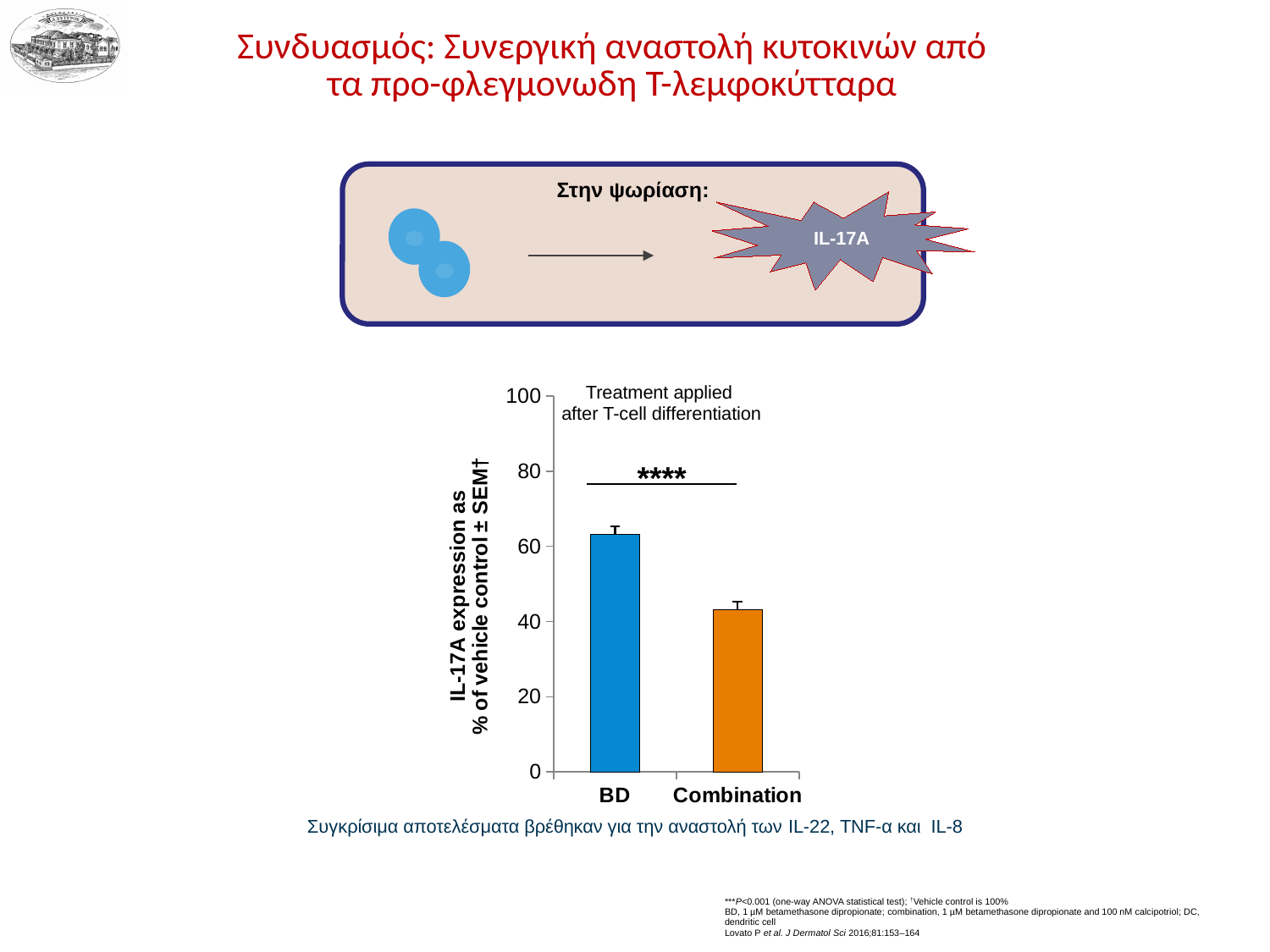
Which category has the highest IL-17A expression in the chart? BD Is the value for Combination greater or less than 60? less Which bar is taller, BD or Combination? BD Is the value for BD greater or less than 60? greater What is the highest tick value shown on the y axis of the chart? 100 What kind of chart is shown on the slide? bar chart What is the label of the y axis of the chart? IL-17A expression as % of vehicle control ± SEM† Do the values rise or fall going from BD to Combination along the x axis? fall Is the value for BD greater or less than 80? less Which category has the lowest IL-17A expression in the chart? Combination How many bars (categories) are plotted in the chart? 2